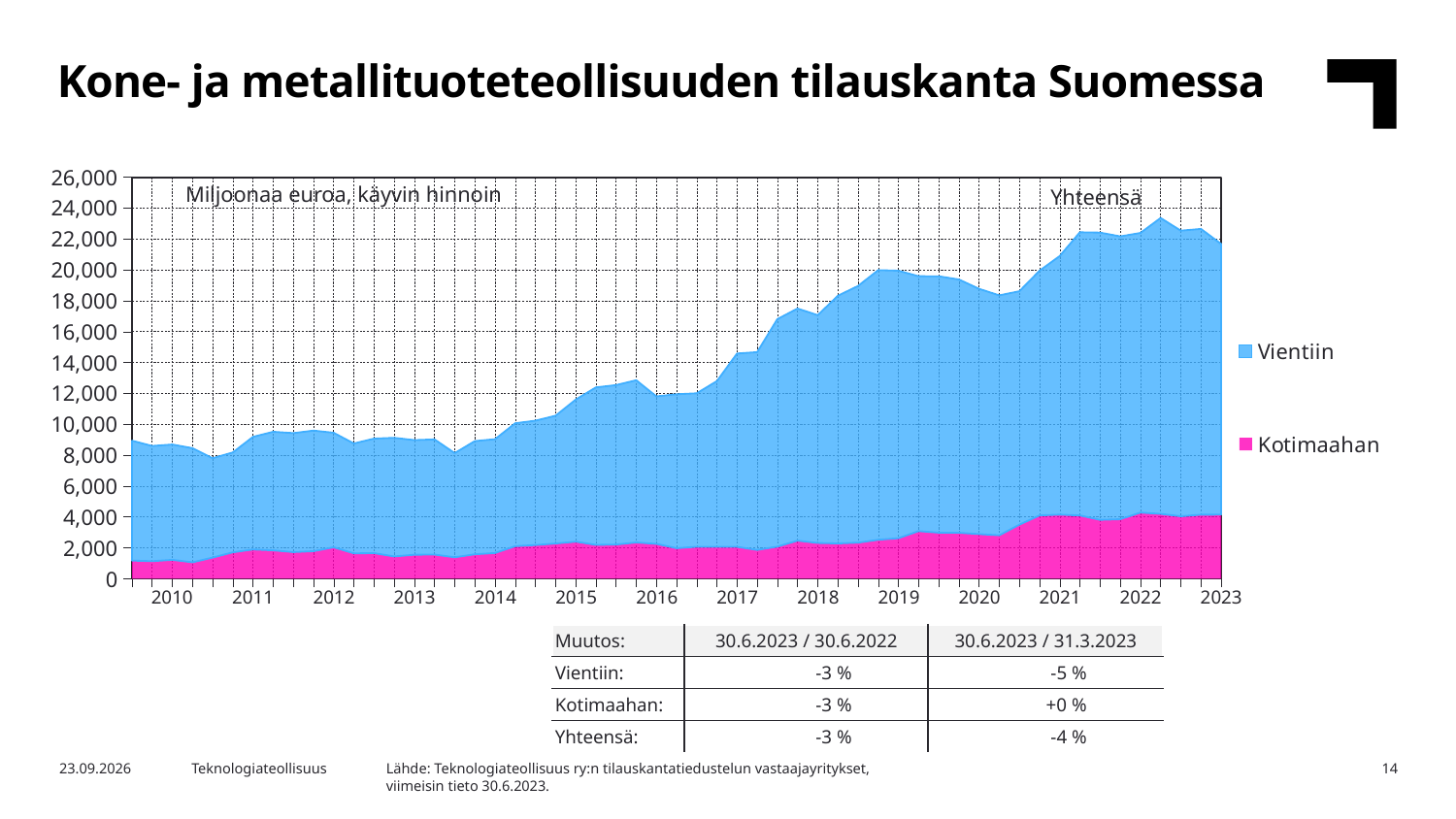
Is the total (Yhteensä) order book at the 2023 end of the chart greater or less than 20,000? greater Is the total (Yhteensä) order book at the start of 2010 greater or less than 10,000? less Which two series are listed in the chart legend? Vientiin and Kotimaahan Is the total (Yhteensä) order book in 2018 greater or less than 16,000? greater How many year labels are shown on the x axis? 14 Does the total order book generally rise or fall from 2010 to 2023? Rise What kind of chart is shown on the slide? Stacked area chart Which series is larger throughout the chart, Vientiin or Kotimaahan? Vientiin What unit is stated in the text inside the chart area? Miljoonaa euroa, käyvin hinnoin How many series does the chart legend list? 2